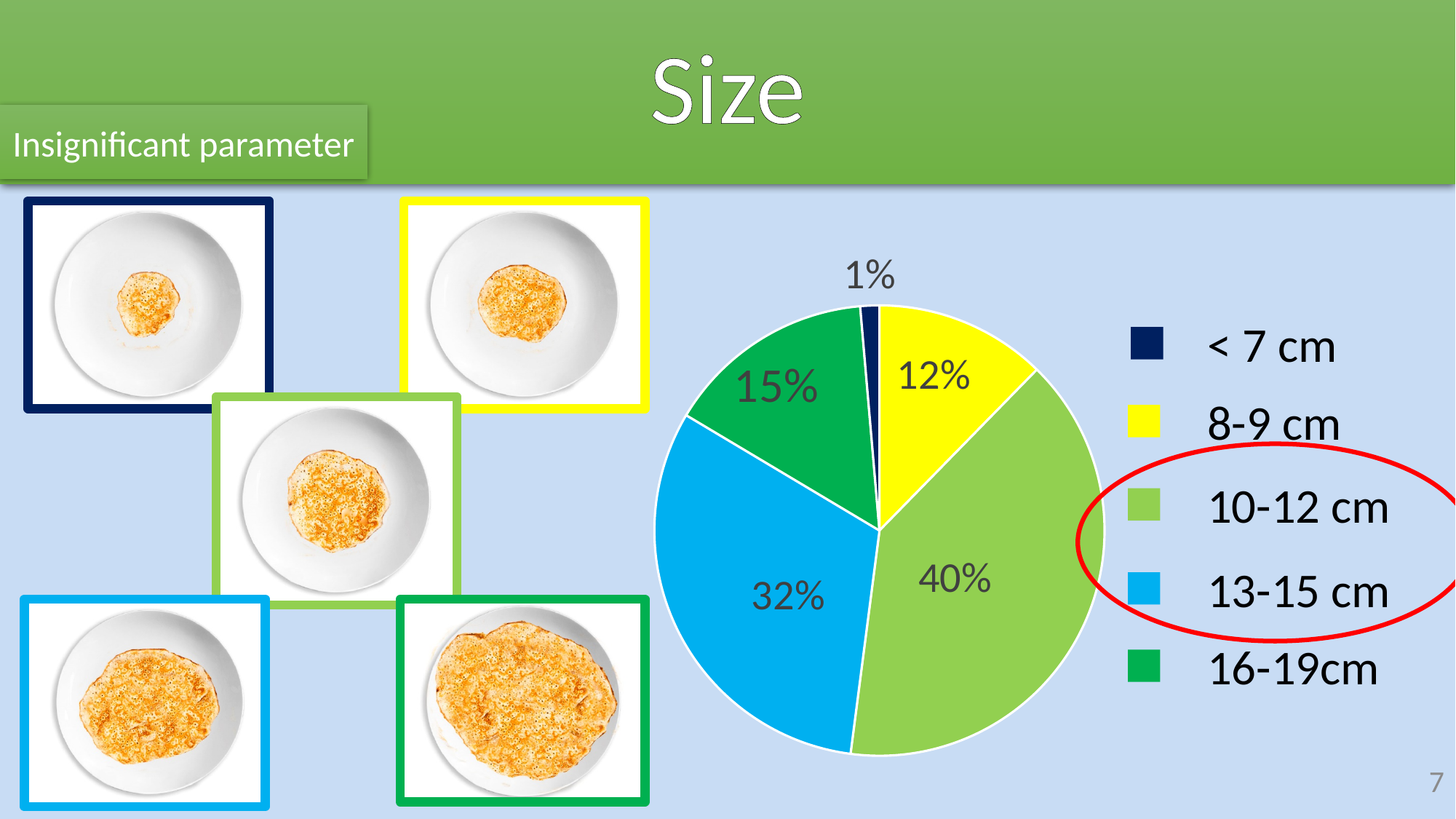
Which legend entries are circled in red on the slide? 10-12 cm and 13-15 cm Which category has the largest slice of the pie? 10-12 cm What is the value shown for the 16-19cm slice? 15% What is the difference between the 10-12 cm and 13-15 cm slices? 8% How many categories does the pie chart have? 5 Which category has the smallest slice of the pie? < 7 cm What kind of chart is shown on the slide? pie chart Which is larger, the 16-19cm slice or the 8-9 cm slice? 16-19cm What is the value shown for the 8-9 cm slice? 12% What is the value shown for the < 7 cm slice? 1% What share of the pie does the 13-15 cm category have? 32% What share of the pie does the 10-12 cm category have? 40%